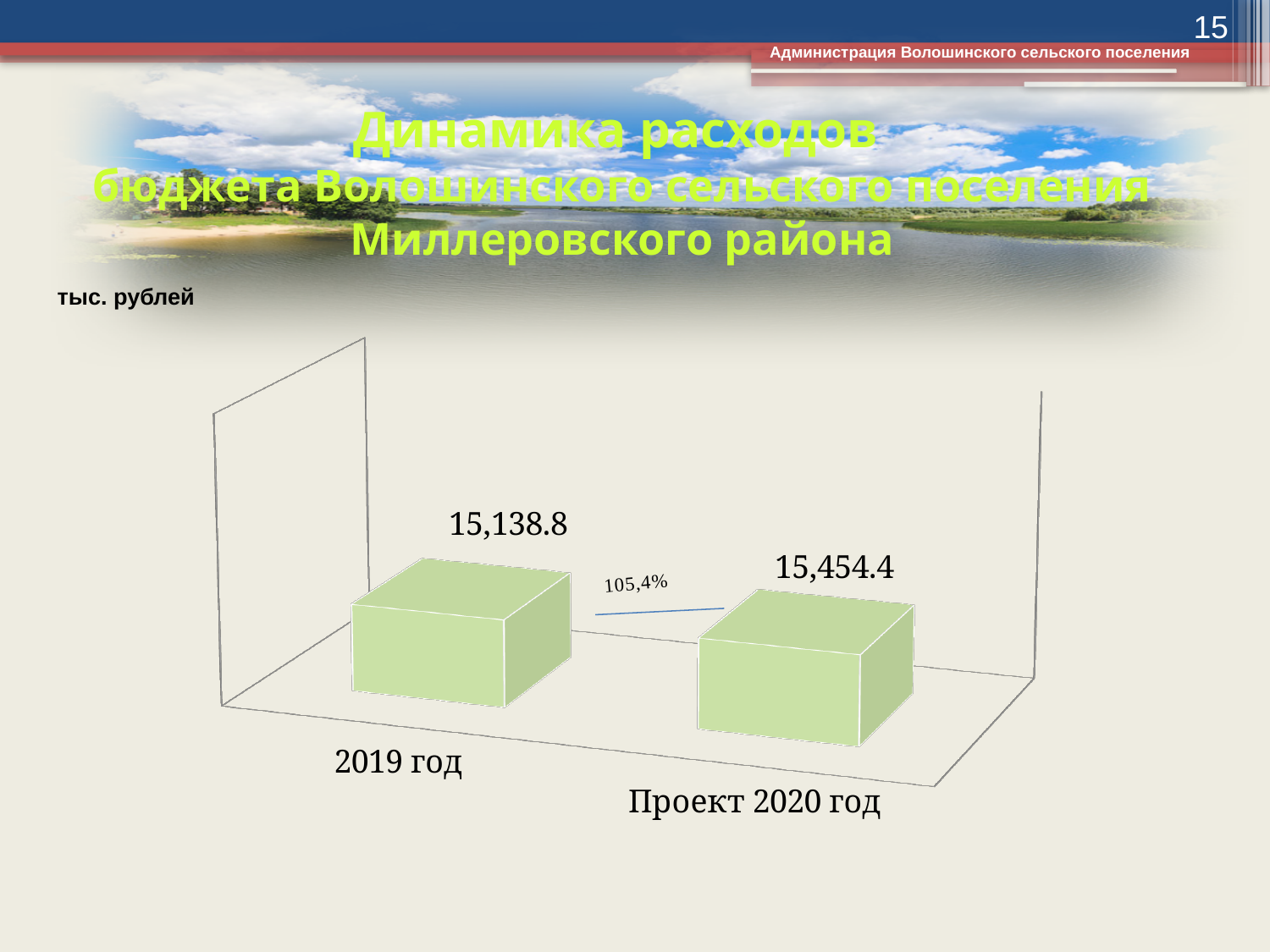
Which category has the lowest value? 2019 год What kind of chart is shown on the slide? bar chart How many categories are shown in the chart? 2 What percentage is printed between the two bars? 105,4% What unit of measurement is indicated above the chart? тыс. рублей Is the value for 2019 год larger or smaller than the value for Проект 2020 год? smaller What is the value for Проект 2020 год? 15,454.4 What is the difference between the value for Проект 2020 год and the value for 2019 год? 315.6 Do the values rise or fall from 2019 год to Проект 2020 год? rise What is the value for 2019 год? 15,138.8 Which category has the higher value, 2019 год or Проект 2020 год? Проект 2020 год